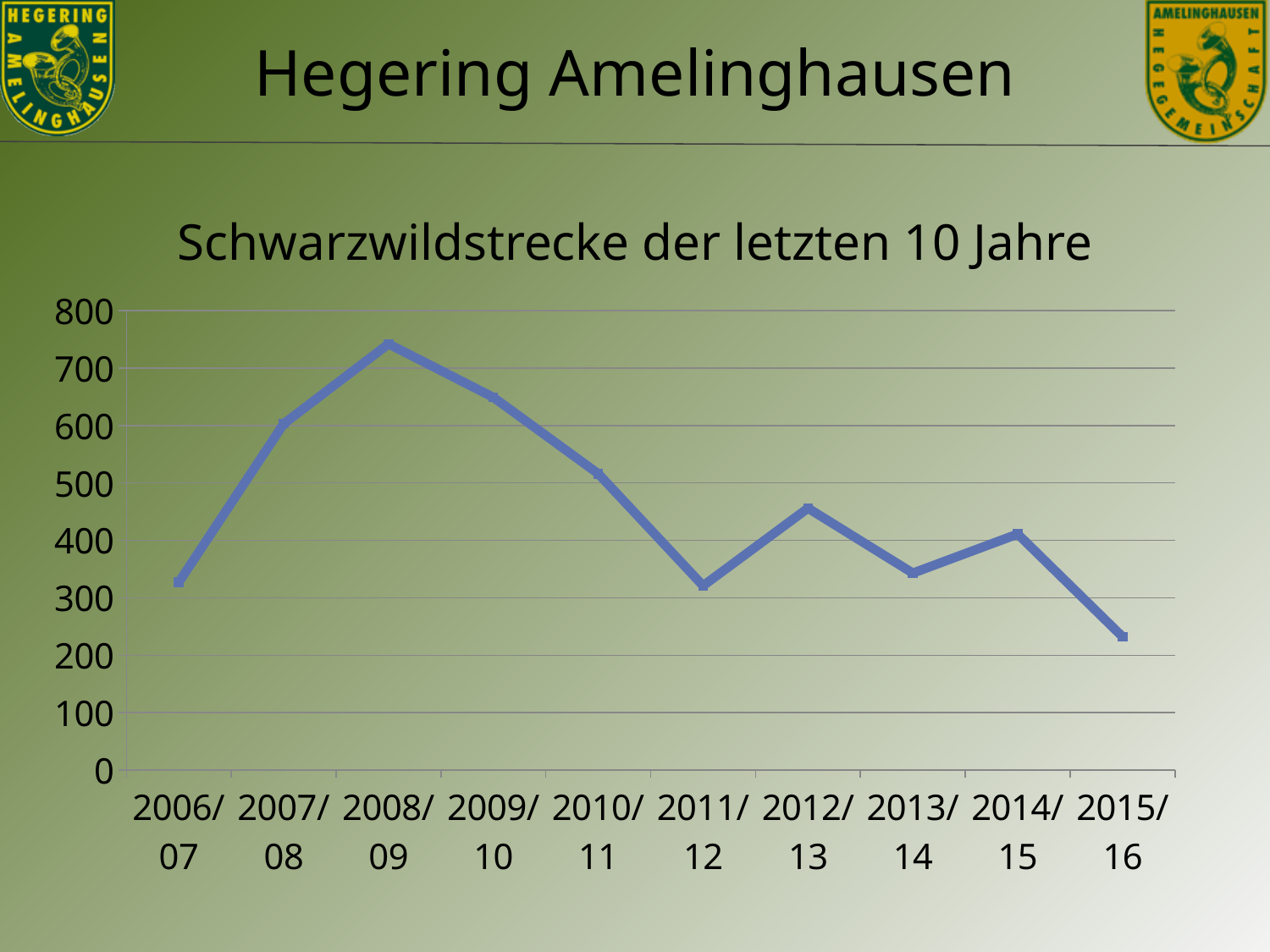
Do the values rise or fall from 2008/09 to 2011/12? fall Which season has the highest value? 2008/09 Is the value for 2015/16 greater or less than 300? less Which season has the lowest value? 2015/16 Which is larger, the value for 2007/08 or the value for 2012/13? 2007/08 What is the highest value shown on the y axis? 800 Is the value for 2009/10 greater or less than 600? greater What kind of chart is shown on the slide? line chart What is the title of the chart? Schwarzwildstrecke der letzten 10 Jahre Is the value for 2013/14 greater or less than 400? less How many hunting seasons are plotted on the x axis? 10